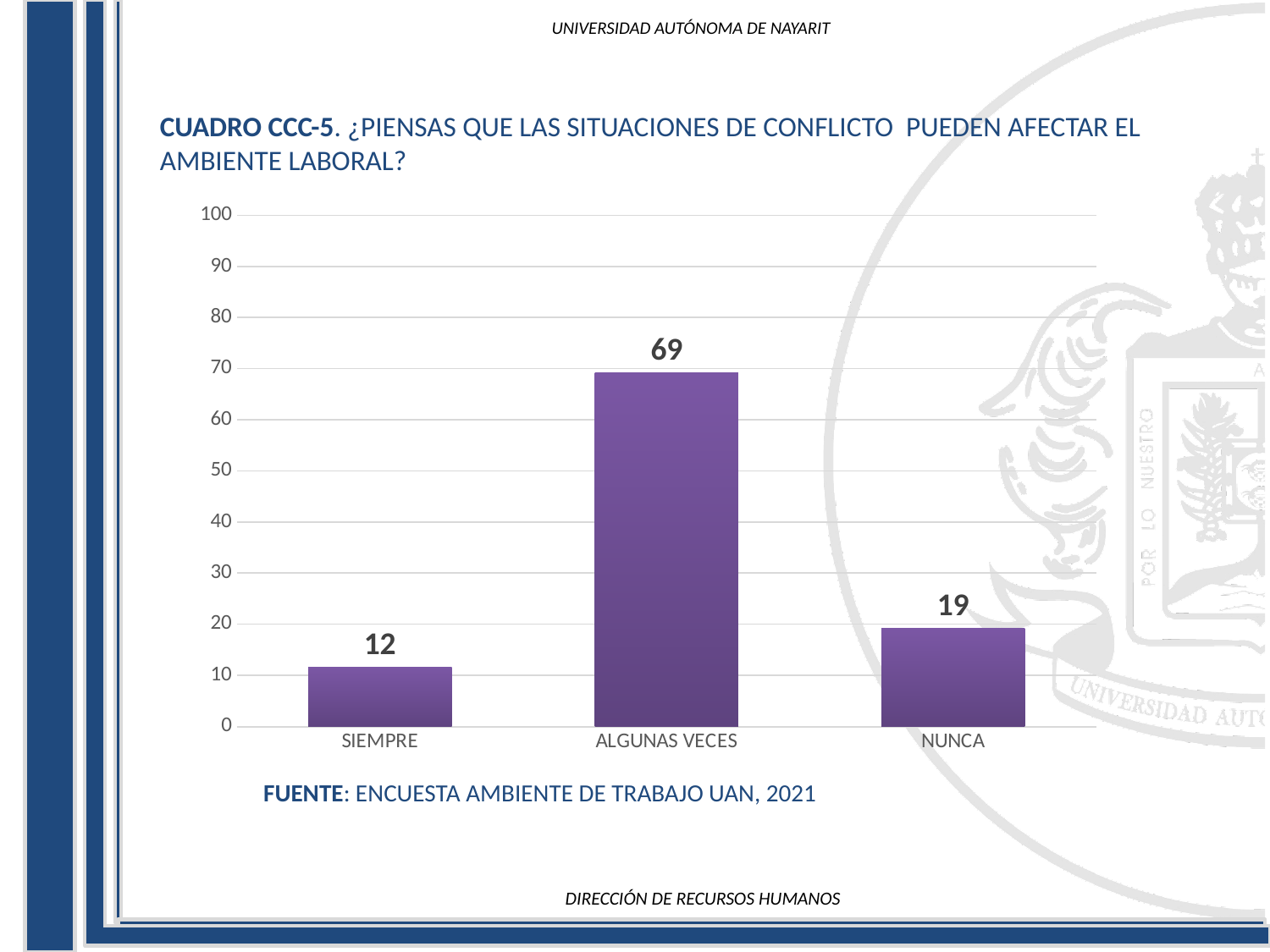
Is the value for ALGUNAS VECES greater or less than 60? greater What is the value for SIEMPRE? 12 What is the difference between the values for ALGUNAS VECES and NUNCA? 50 What is the value for ALGUNAS VECES? 69 Which category has the lowest value? SIEMPRE What source is cited below the chart? ENCUESTA AMBIENTE DE TRABAJO UAN, 2021 What is the difference between the values for NUNCA and SIEMPRE? 7 What kind of chart is shown on the slide? bar chart What is the value for NUNCA? 19 How many categories are shown on the x axis? 3 Which category has the highest value? ALGUNAS VECES Which is larger, the value for NUNCA or the value for SIEMPRE? NUNCA